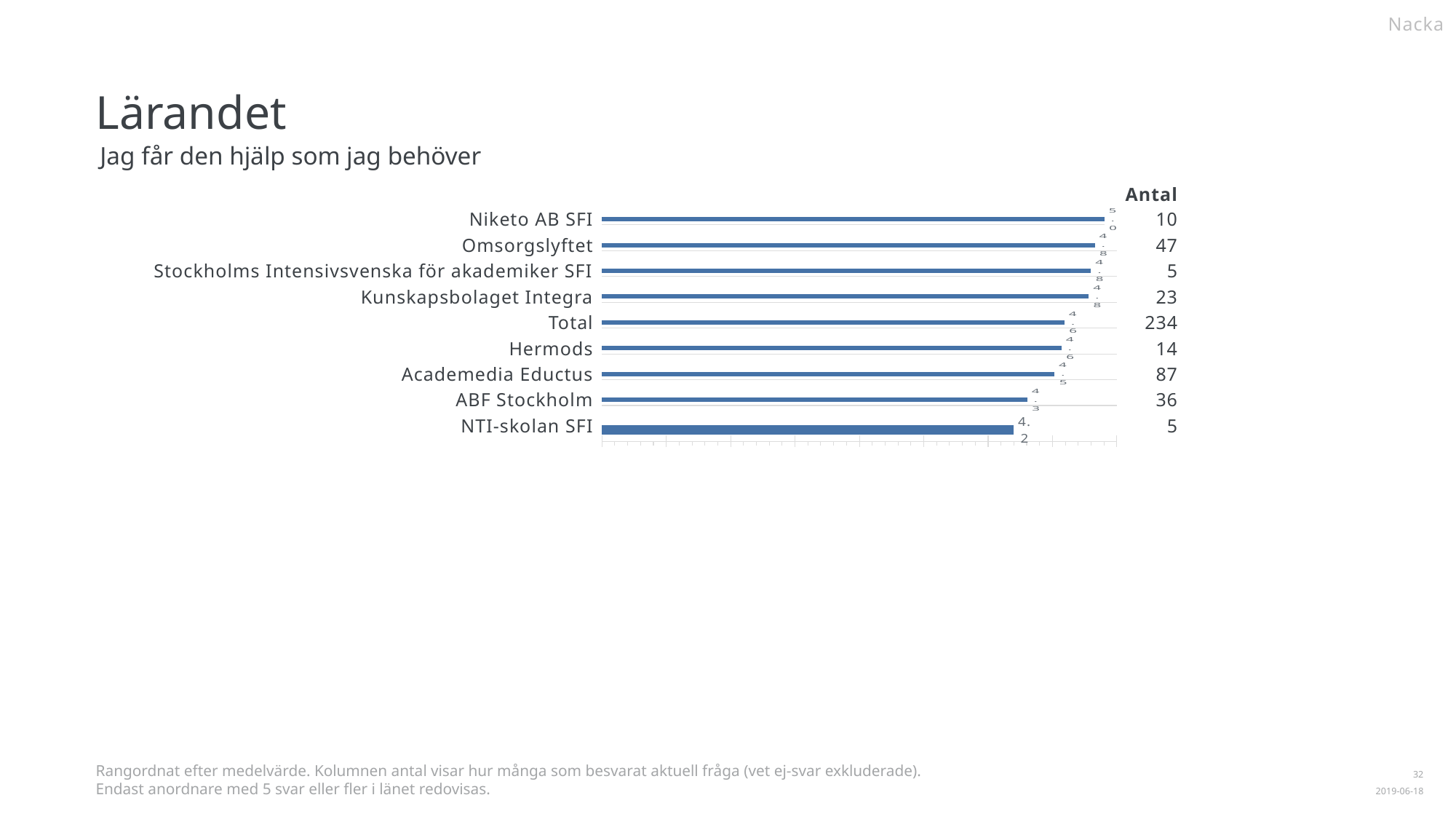
What is the mean value shown for Niketo AB SFI? 5.0 What is the difference in Antal between Academedia Eductus and ABF Stockholm? 51 What kind of chart is shown on the slide? bar chart What is the Antal (number of respondents) for Total? 234 What is the mean value shown for NTI-skolan SFI? 4.2 What is the difference between the mean values of Niketo AB SFI and NTI-skolan SFI? 0.8 How many categories (bars) does the chart show? 9 What is the mean value shown for ABF Stockholm? 4.3 Which category has the shortest bar (lowest mean value)? NTI-skolan SFI What is the Antal (number of respondents) for Academedia Eductus? 87 Which category has the longest bar (highest mean value)? Niketo AB SFI Which has a higher mean value, Niketo AB SFI or ABF Stockholm? Niketo AB SFI